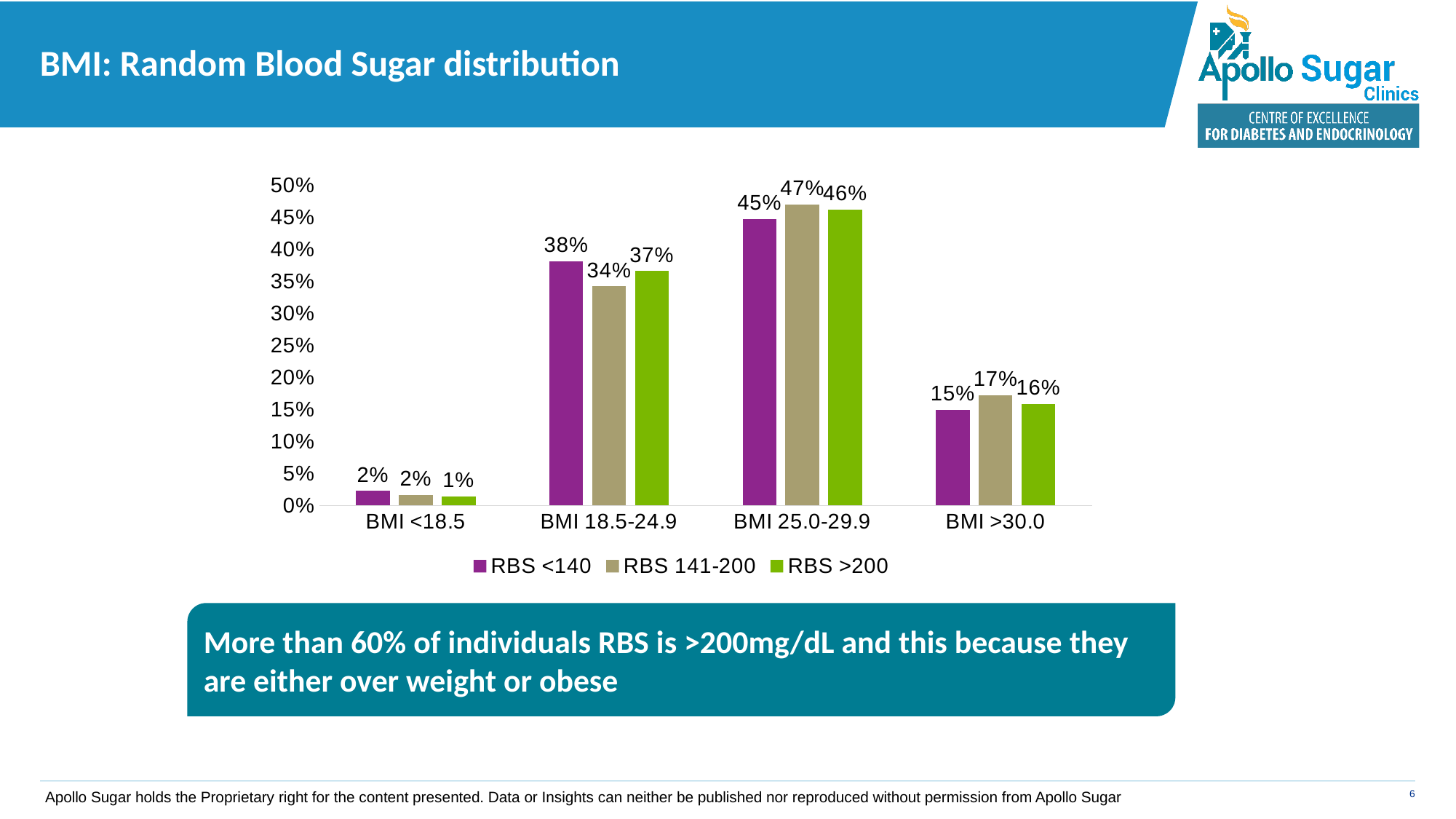
What is the difference between the RBS >200 values for BMI 25.0-29.9 and BMI >30.0? 30% Which colour represents the RBS >200 series in the legend? Green Which BMI category has the lowest value for RBS <140? BMI <18.5 What is the value for RBS 141-200 in the BMI 25.0-29.9 category? 47% How many BMI categories are shown on the x axis? 4 Which is larger in the BMI >30.0 category: RBS <140 or RBS 141-200? RBS 141-200 What is the difference between the RBS <140 and RBS 141-200 values in the BMI 18.5-24.9 category? 4% What is the value for RBS <140 in the BMI 18.5-24.9 category? 38% Which BMI category has the highest value for RBS >200? BMI 25.0-29.9 What is the value for RBS >200 in the BMI >30.0 category? 16% What kind of chart is shown on the slide? Bar chart How many series does the legend list? 3